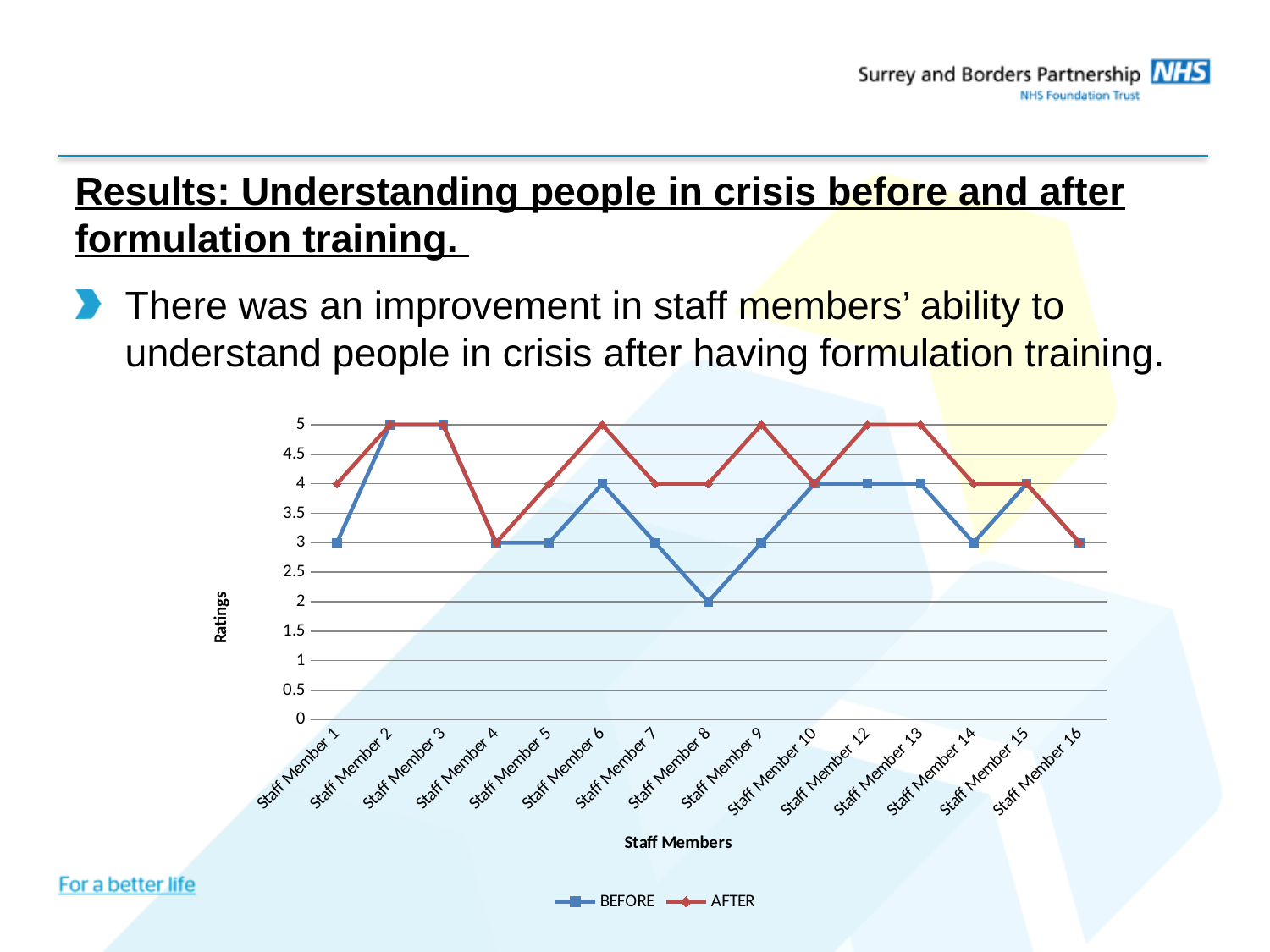
What is the difference between the AFTER and BEFORE ratings for Staff Member 8? 2 How many series does the chart's legend list? 2 For Staff Member 9, which is larger, the BEFORE rating or the AFTER rating? AFTER What is the title of the chart's vertical axis? Ratings What is the BEFORE rating for Staff Member 8? 2 How many staff members are plotted along the x axis of the chart? 15 What is the BEFORE rating for Staff Member 1? 3 What kind of chart is shown on the slide? Line chart What is the AFTER rating for Staff Member 6? 5 Which staff member has the lowest BEFORE rating? Staff Member 8 Is the BEFORE rating for Staff Member 2 greater or less than 4? greater What is the AFTER rating for Staff Member 16? 3